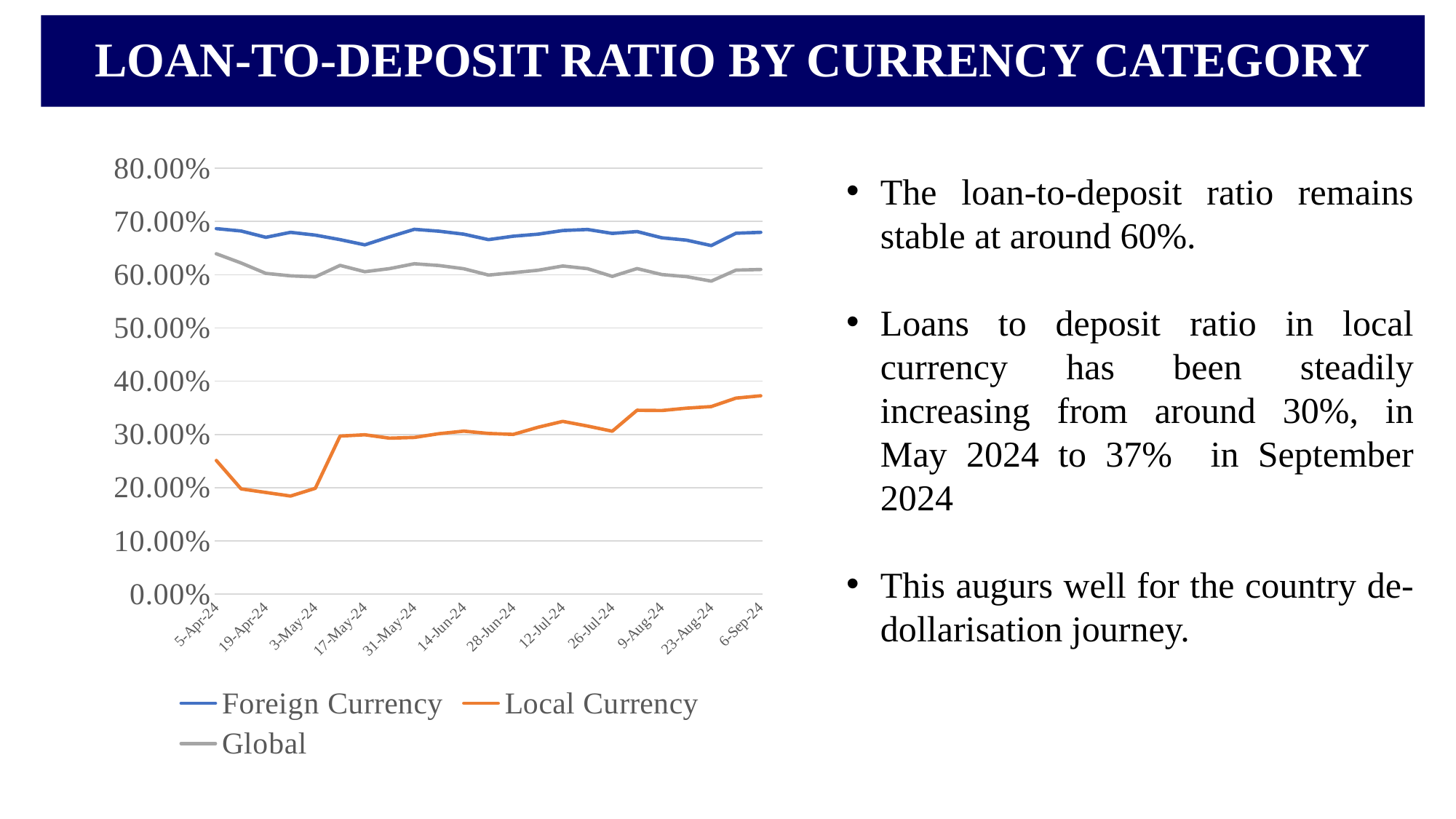
Which series has the lowest values throughout the chart? Local Currency Is the value for Global at 5-Apr-24 greater or less than 60%? greater At 6-Sep-24, which is larger: Foreign Currency or Local Currency? Foreign Currency Does the Local Currency series rise or fall overall from 5-Apr-24 to 6-Sep-24? rise Is the value for Local Currency at 6-Sep-24 greater or less than 30%? greater Is the value for Local Currency at 5-Apr-24 greater or less than 20%? greater Which series has the highest values throughout the chart? Foreign Currency What colour is the Local Currency line? orange What kind of chart is shown on the slide? line chart How many series does the legend list? 3